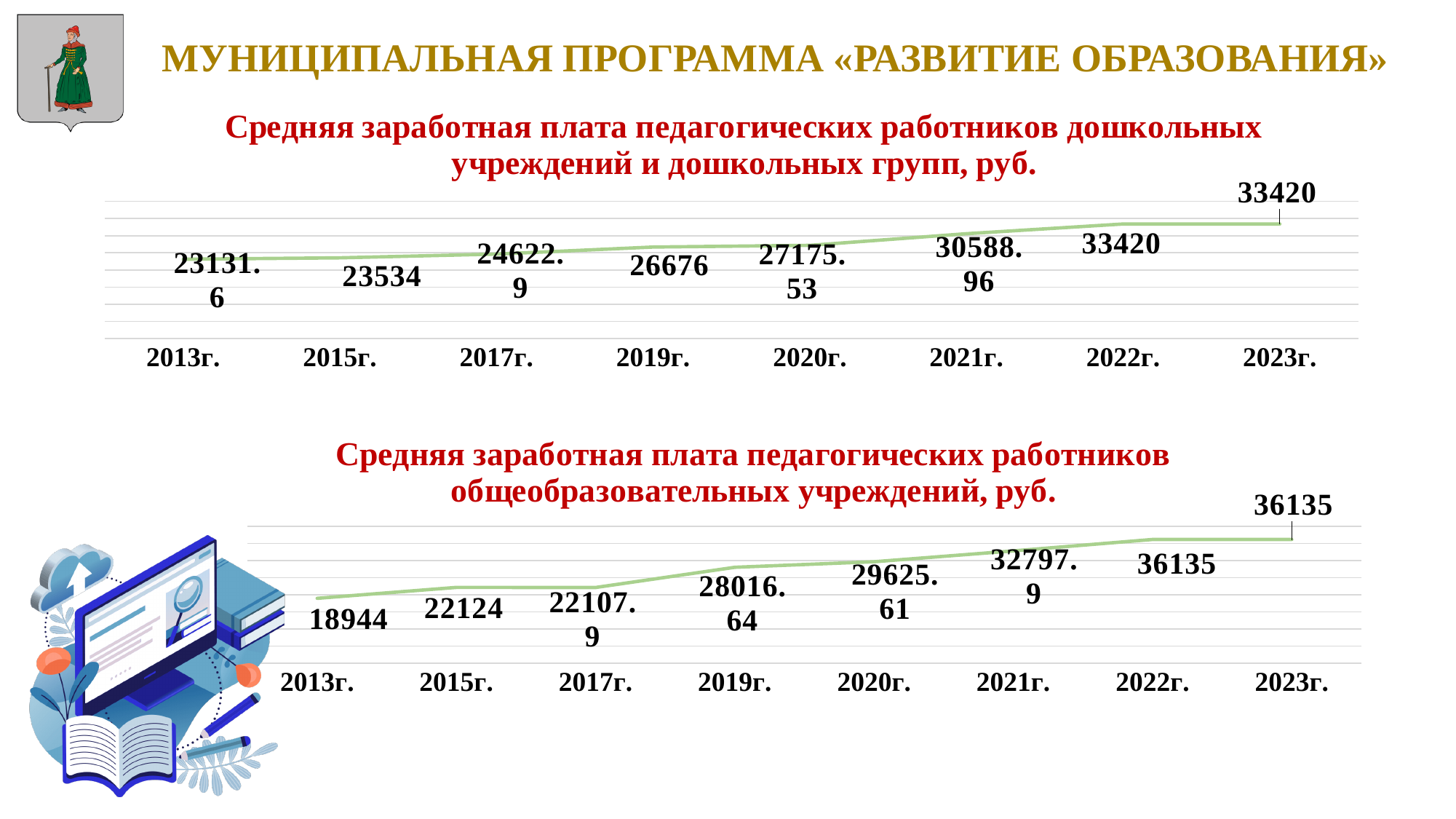
In the top chart (preschool institutions), which year has the lowest value? 2013г. In the bottom chart (general education institutions), what is the value for 2020г.? 29625.61 What type of chart is the bottom chart (general education institutions)? Line chart In the top chart (preschool institutions), what is the average salary for 2019г.? 26676 In the bottom chart (general education institutions), what is the value for 2013г.? 18944 In the top chart (preschool institutions), what is the difference between the values for 2015г. and 2013г.? 402.4 In the top chart (preschool institutions), what is the value for 2021г.? 30588.96 In the bottom chart (general education institutions), which year has the lowest value? 2013г. In the bottom chart (general education institutions), what is the difference between the values for 2019г. and 2017г.? 5908.74 How many data points are plotted in the top chart (preschool institutions)? 8 In the bottom chart (general education institutions), which is larger: the value for 2015г. or for 2017г.? 2015г. In the top chart (preschool institutions), do the values generally rise or fall from 2013г. to 2023г.? Rise